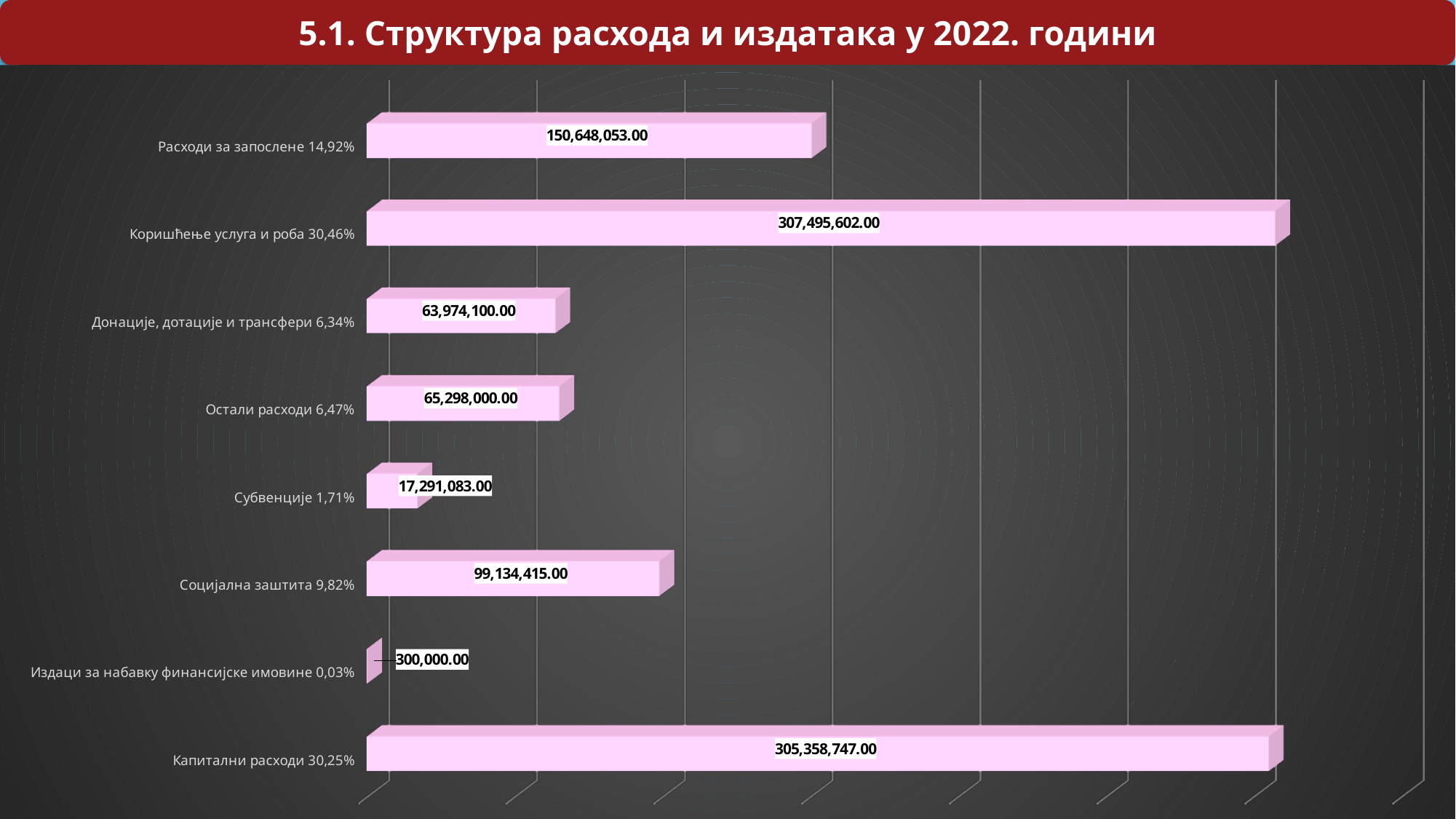
What percentage is shown in the label for Капитални расходи? 30,25% Which is larger, the value for Социјална заштита or the value for Субвенције? Социјална заштита Which is larger, the value for Остали расходи or the value for Донације, дотације и трансфери? Остали расходи Which category has the lowest value? Издаци за набавку финансијске имовине What is the difference between the values for Расходи за запослене and Социјална заштита? 51,513,638.00 What is the value for Субвенције? 17,291,083.00 Which category has the highest value? Коришћење услуга и роба How many categories are shown in the chart? 8 What is the value for Социјална заштита? 99,134,415.00 What is the value for Расходи за запослене? 150,648,053.00 What is the difference between the values for Коришћење услуга и роба and Капитални расходи? 2,136,855.00 What kind of chart is shown on the slide? Bar chart